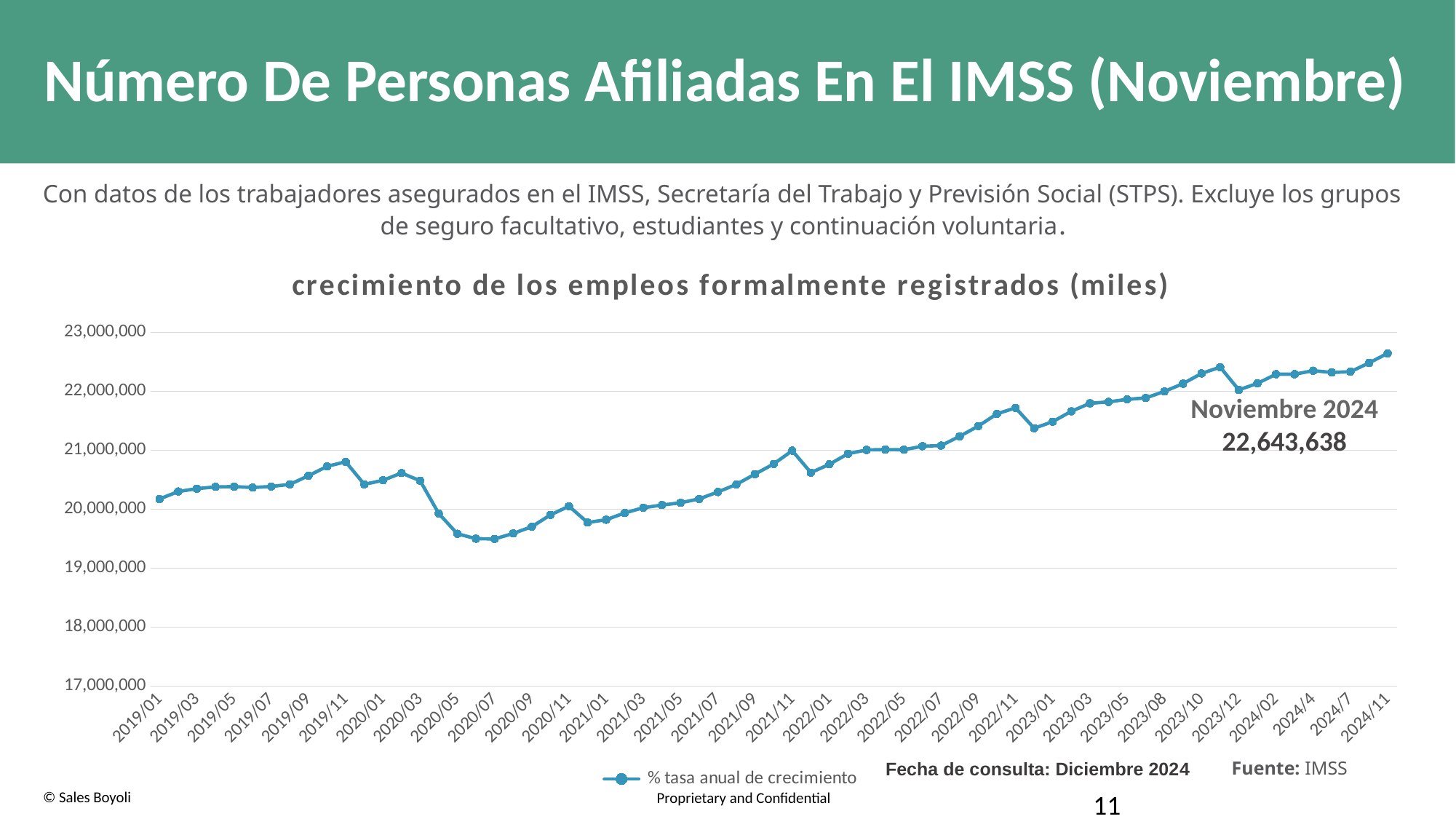
Is the value for 2023/10 greater or less than 22,000,000? greater Overall, do the values rise or fall from 2019/01 to 2024/11? rise Is the value for 2022/11 greater or less than 22,000,000? less Which is larger, the value for 2023/11 or the value for 2023/12? 2023/11 What kind of chart is shown on the slide? line chart How many series does the chart legend list? 1 Is the value for 2020/07 greater or less than 20,000,000? less Which is larger, the value for 2019/11 or the value for 2020/07? 2019/11 What is the series name shown in the chart legend? % tasa anual de crecimiento What value is labelled on the chart for Noviembre 2024? 22,643,638 Which x-axis date has the highest value on the chart? 2024/11 What is the title of the chart? crecimiento de los empleos formalmente registrados (miles)